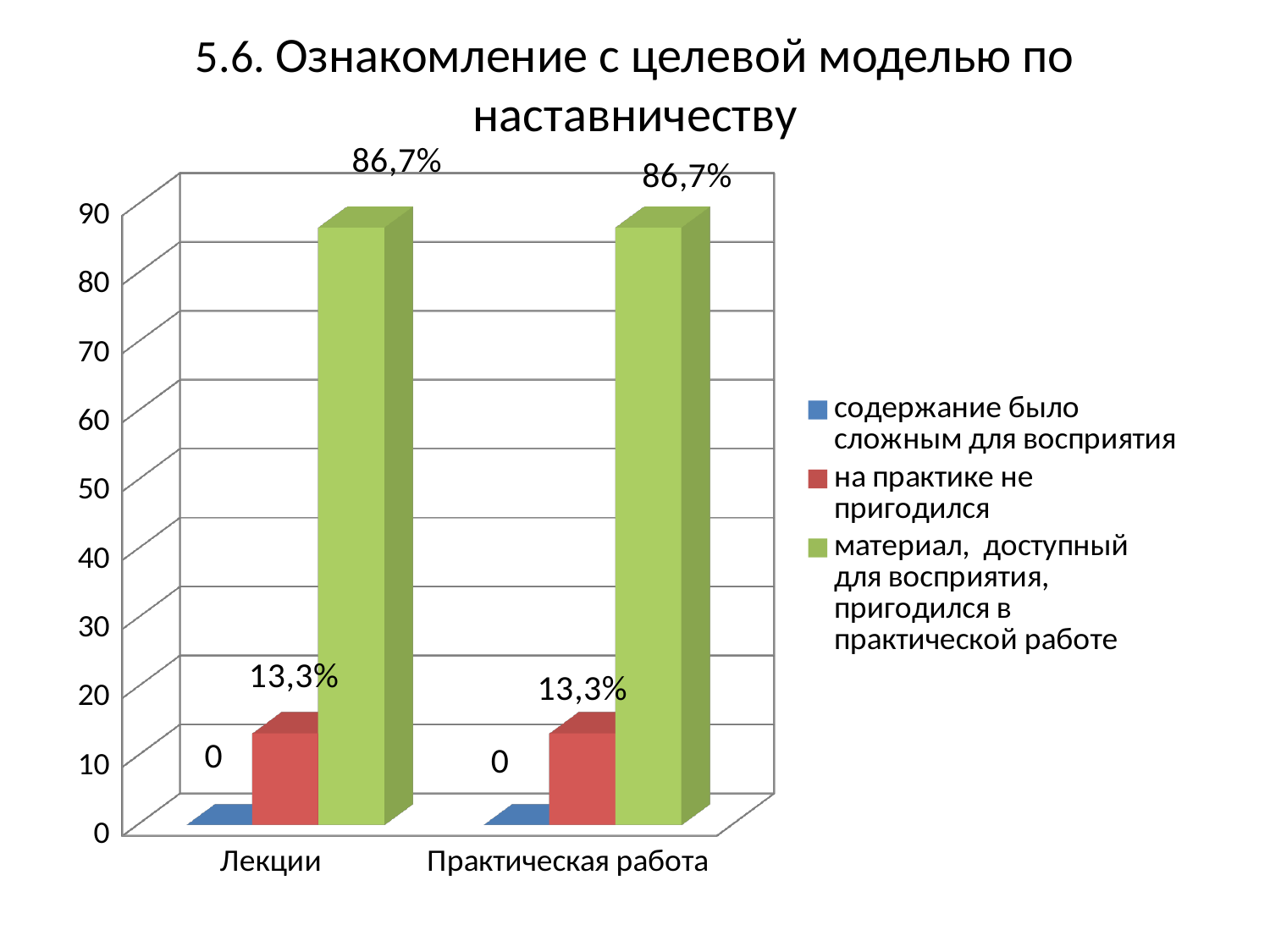
How many categories are shown on the x axis? 2 What is the difference between the values for "материал, доступный для восприятия, пригодился в практической работе" and "на практике не пригодился" in the Лекции category? 73,4% What is the value for "содержание было сложным для восприятия" in the Лекции category? 0 What kind of chart is shown on the slide? bar chart What is the value for "материал, доступный для восприятия, пригодился в практической работе" in the Лекции category? 86,7% How many series does the legend list? 3 What is the title of the slide? 5.6. Ознакомление с целевой моделью по наставничеству In the Практическая работа category, which is larger: "на практике не пригодился" or "материал, доступный для восприятия, пригодился в практической работе"? материал, доступный для восприятия, пригодился в практической работе Which series has the lowest value in the Лекции category? содержание было сложным для восприятия Is the value for "на практике не пригодился" in the Лекции category greater or less than 20? less What is the value for "на практике не пригодился" in the Практическая работа category? 13,3% Which series has the highest value in the Практическая работа category? материал, доступный для восприятия, пригодился в практической работе